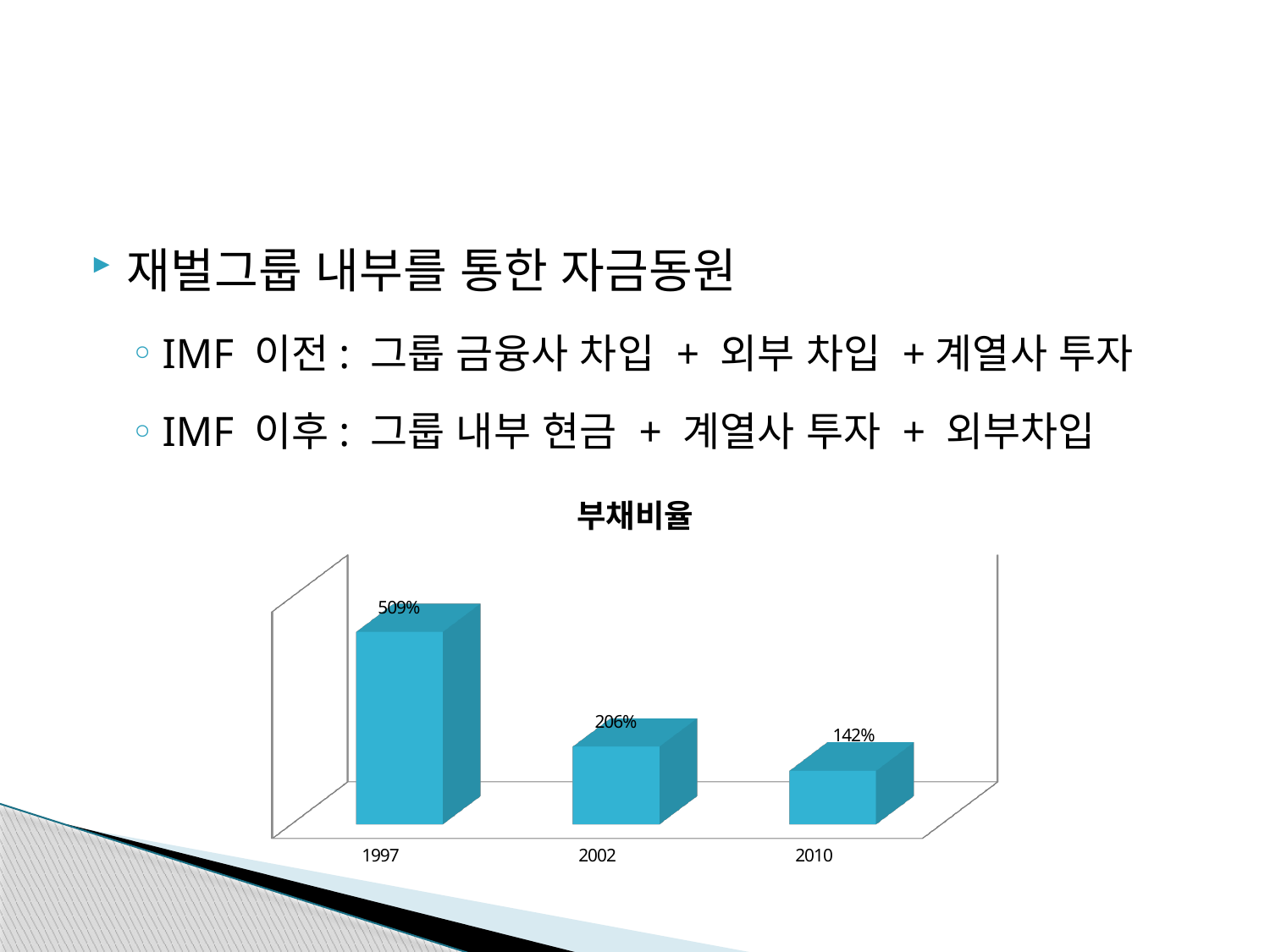
What is the title of the chart? 부채비율 Which year has the highest value? 1997 What is the difference between the values for 1997 and 2002? 303% What kind of chart is this? bar chart Do the values rise or fall from 1997 to 2010? fall Which year has the lowest value? 2010 What is the value for 2010? 142% What is the difference between the values for 2002 and 2010? 64% What is the value for 2002? 206% How many years are shown on the x axis? 3 Which is larger, the value for 2002 or the value for 2010? 2002 What is the value for 1997? 509%